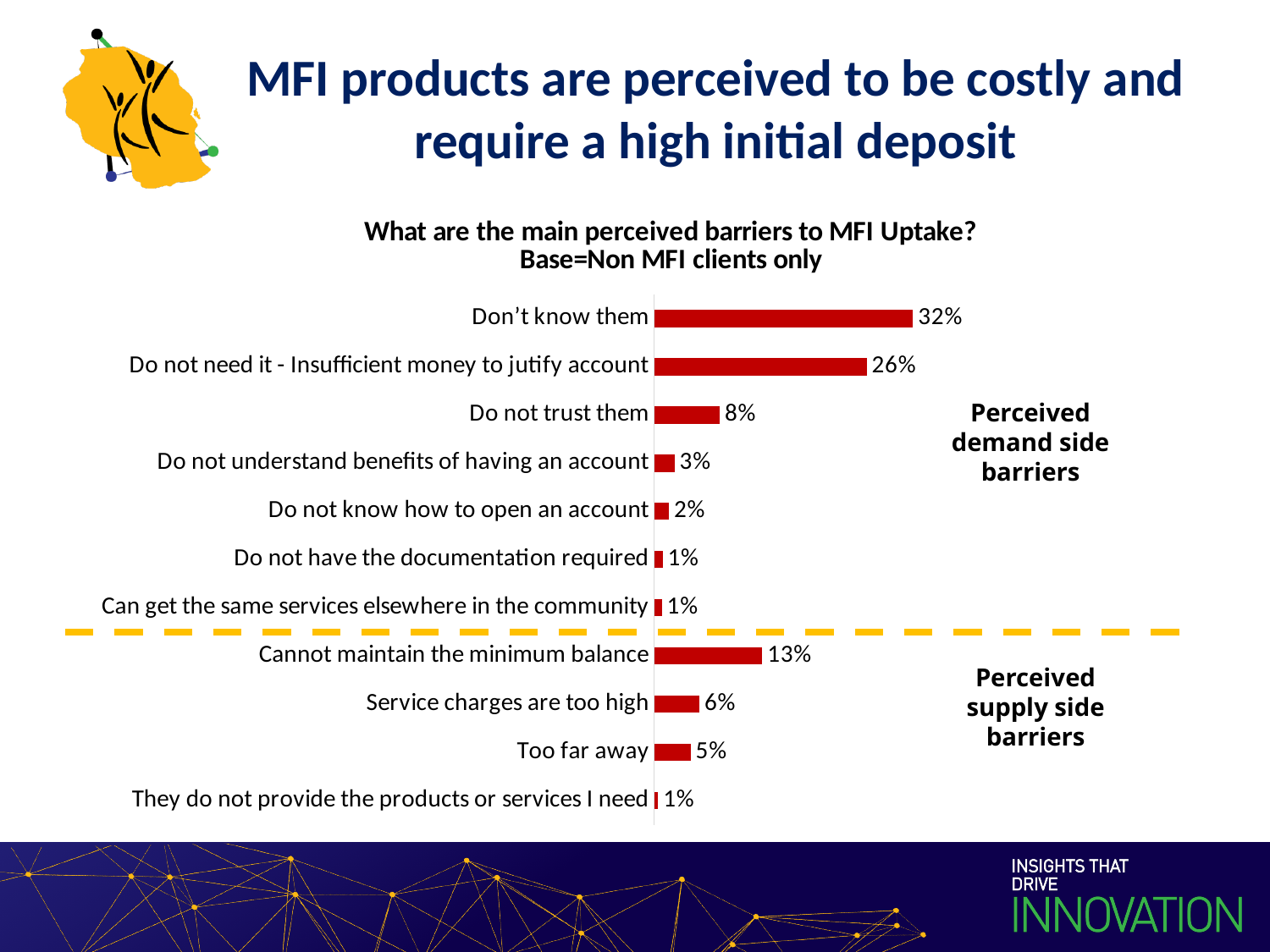
What is the value for "Cannot maintain the minimum balance"? 13% Which barrier has the highest percentage? Don't know them What percentage cited "Service charges are too high" as a barrier? 6% What colour are the bars in the chart? Red What is the difference between "Don't know them" and "Do not need it - Insufficient money to jutify account"? 6% What percentage of non-MFI clients said they don't know them? 32% What is the difference between "Service charges are too high" and "Too far away"? 1% What is the value for "Do not trust them"? 8% What type of chart is shown on the slide? Bar chart What is the title of the chart? What are the main perceived barriers to MFI Uptake? Base=Non MFI clients only How many barriers are plotted in the chart? 11 Which is larger: "Cannot maintain the minimum balance" or "Do not trust them"? Cannot maintain the minimum balance